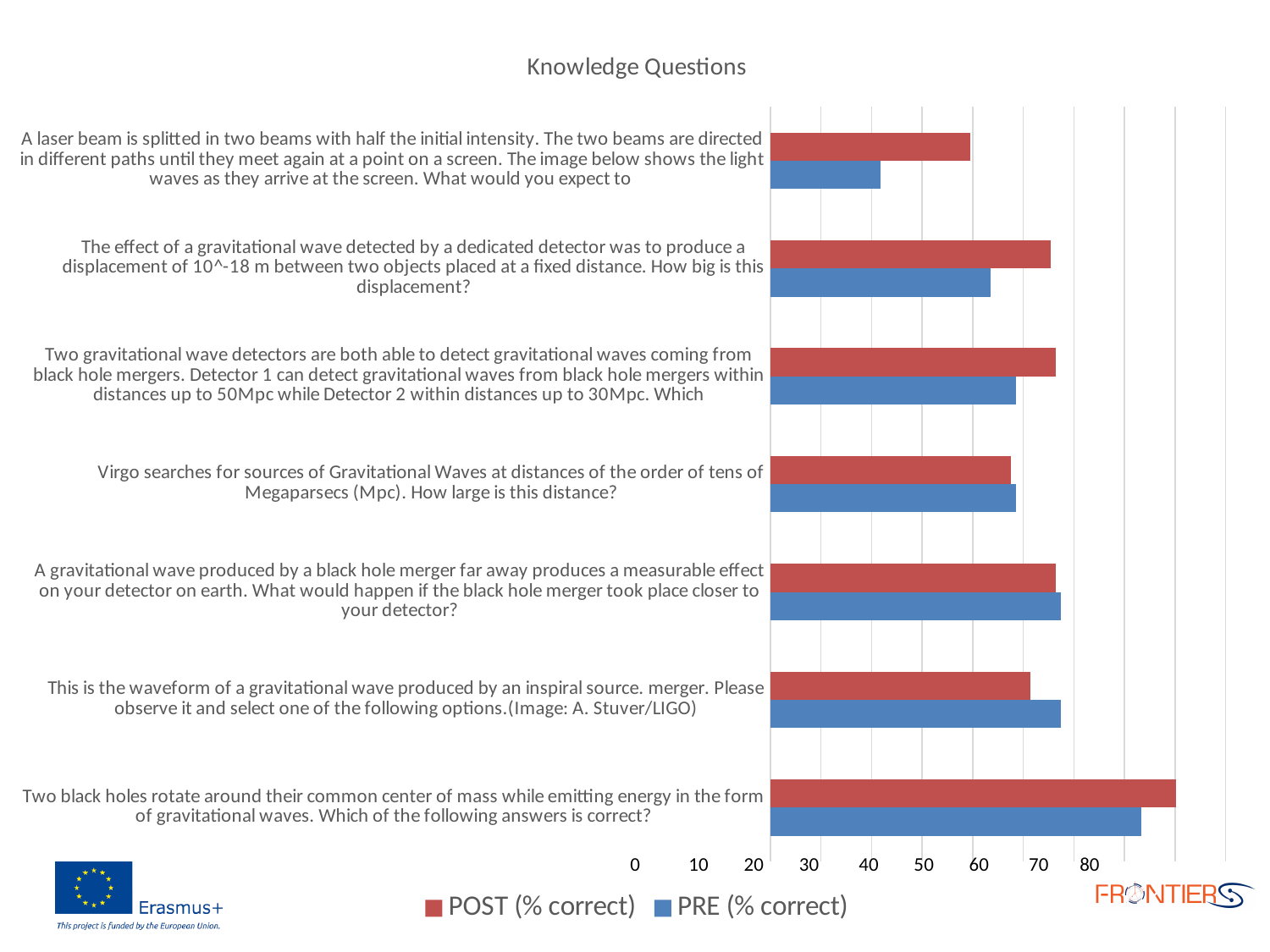
Which question has the highest PRE (% correct) value? Two black holes rotate around their common center of mass while emitting energy in the form of gravitational waves. Which of the following answers is correct? For the question about the displacement of 10^-18 m between two objects, which is larger: POST (% correct) or PRE (% correct)? POST (% correct) How many knowledge questions (categories) are plotted on the chart? 7 For the laser beam question, which is larger: POST (% correct) or PRE (% correct)? POST (% correct) How many series does the legend list? 2 For the question about the waveform of a gravitational wave produced by an inspiral source, which is larger: POST (% correct) or PRE (% correct)? PRE (% correct) Which question has the highest POST (% correct) value? Two black holes rotate around their common center of mass while emitting energy in the form of gravitational waves. Which of the following answers is correct? What is the title of the chart? Knowledge Questions What kind of chart is shown on the slide? bar chart Which series is shown in red? POST (% correct)